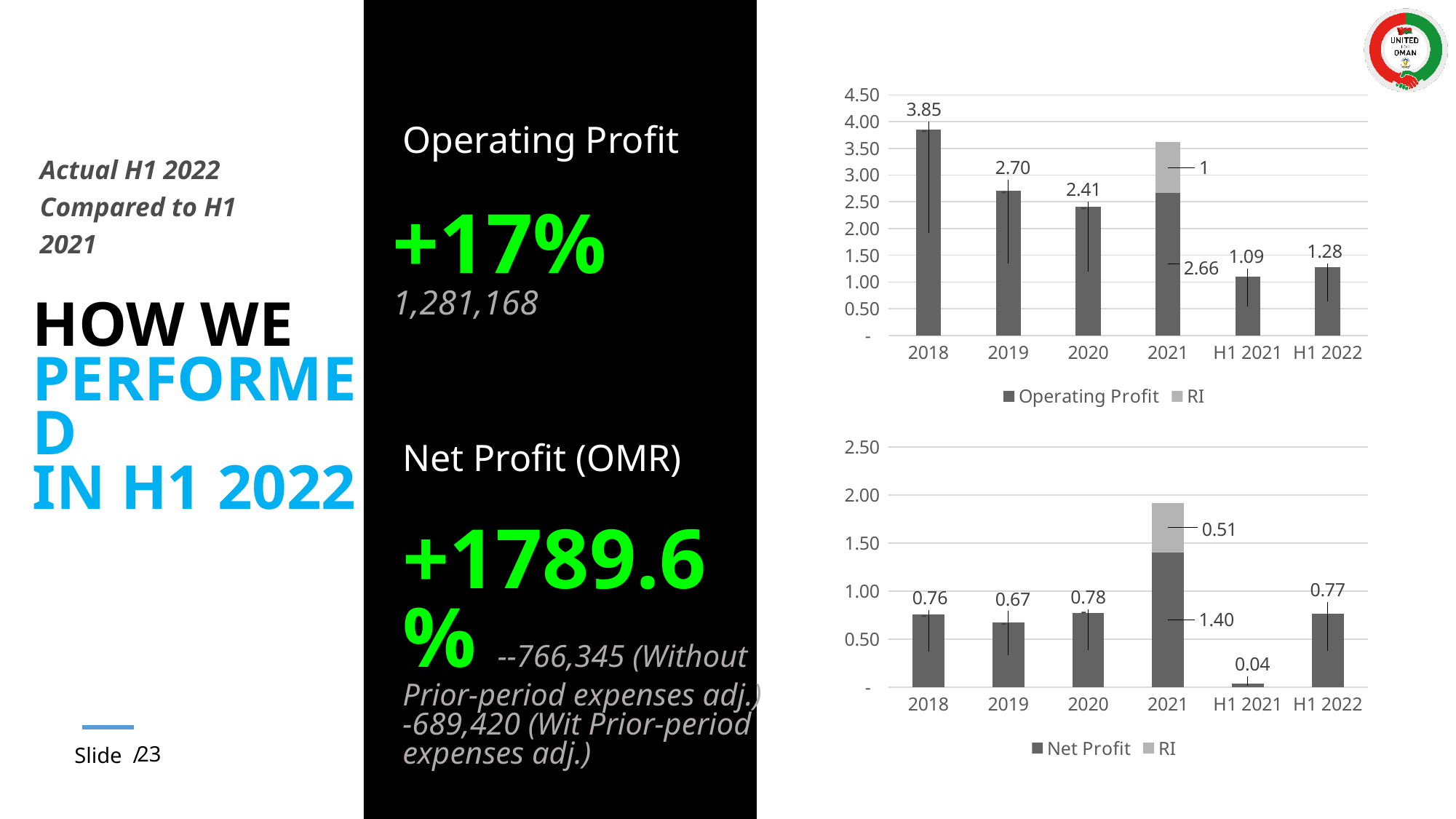
In the bottom chart (Net Profit), which category has the lowest Net Profit value? H1 2021 What kind of chart is the bottom chart (Net Profit)? Bar chart In the bottom chart (Net Profit), what is the total of the stacked bar for 2021? 1.91 In the bottom chart (Net Profit), what is the Net Profit value for H1 2021? 0.04 In the bottom chart (Net Profit), is the Net Profit value for 2019 larger or smaller than the value for 2020? smaller In the top chart (Operating Profit), what is the difference between the Operating Profit values for H1 2022 and H1 2021? 0.19 In the top chart (Operating Profit), which category has the highest Operating Profit value? 2018 In the top chart (Operating Profit), what is the RI value for 2021? 1 In the top chart (Operating Profit), how many series does the legend list? 2 In the top chart (Operating Profit), what is the Operating Profit value for 2018? 3.85 In the bottom chart (Net Profit), how many categories are shown on the x axis? 6